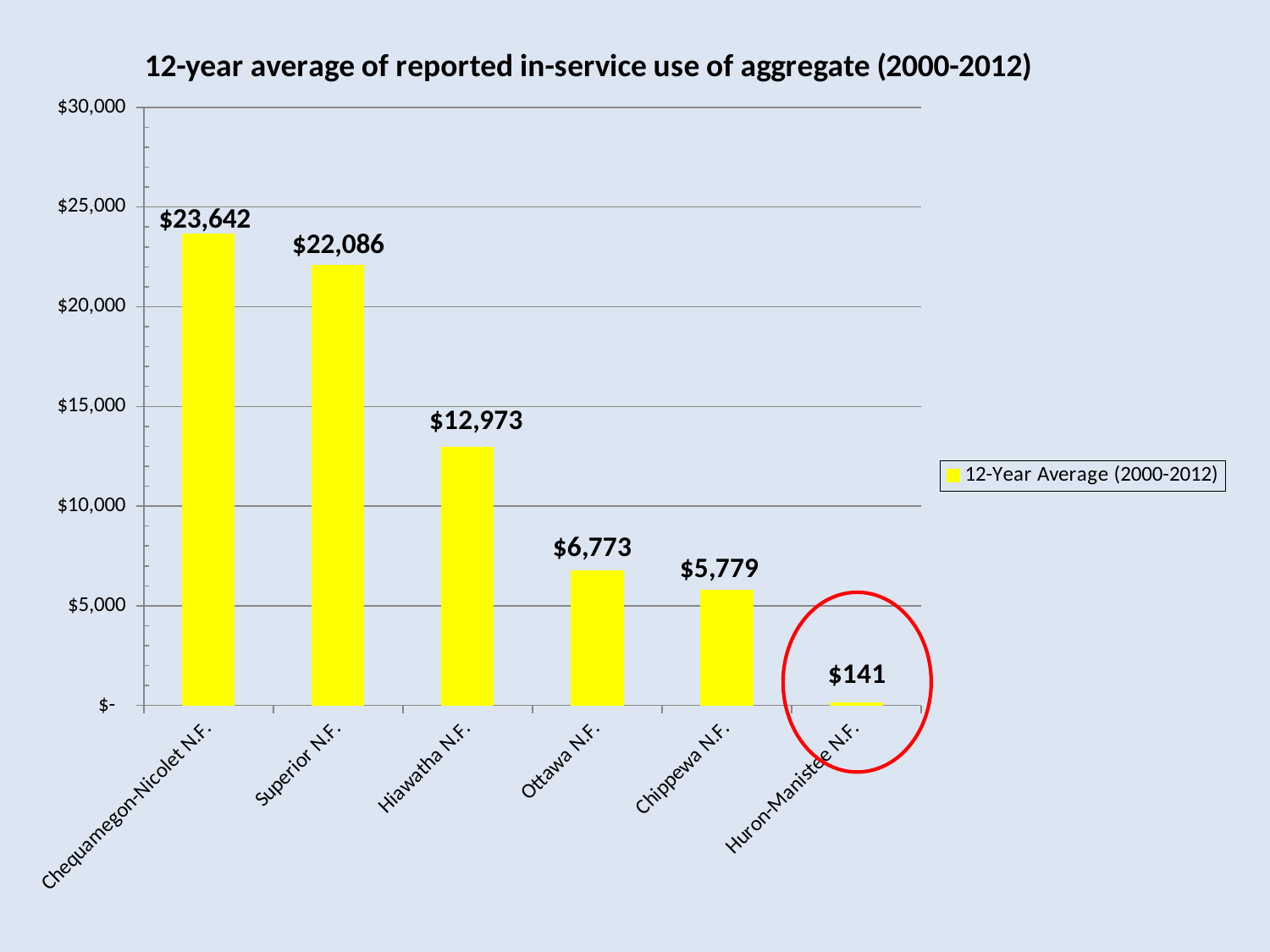
Which national forest has the highest 12-year average? Chequamegon-Nicolet N.F. What kind of chart is shown on the slide? Bar chart Is the value for Chippewa N.F. greater or less than $5,000? greater What is the difference between the values for Ottawa N.F. and Chippewa N.F.? $994 What is the legend entry shown on the chart? 12-Year Average (2000-2012) What is the 12-year average value for Huron-Manistee N.F.? $141 How many national forests are shown on the chart? 6 What is the difference between the values for Chequamegon-Nicolet N.F. and Superior N.F.? $1,556 What is the 12-year average value for Ottawa N.F.? $6,773 What is the 12-year average value for Hiawatha N.F.? $12,973 Which national forest has the lowest 12-year average? Huron-Manistee N.F. Which has a larger value, Superior N.F. or Hiawatha N.F.? Superior N.F.